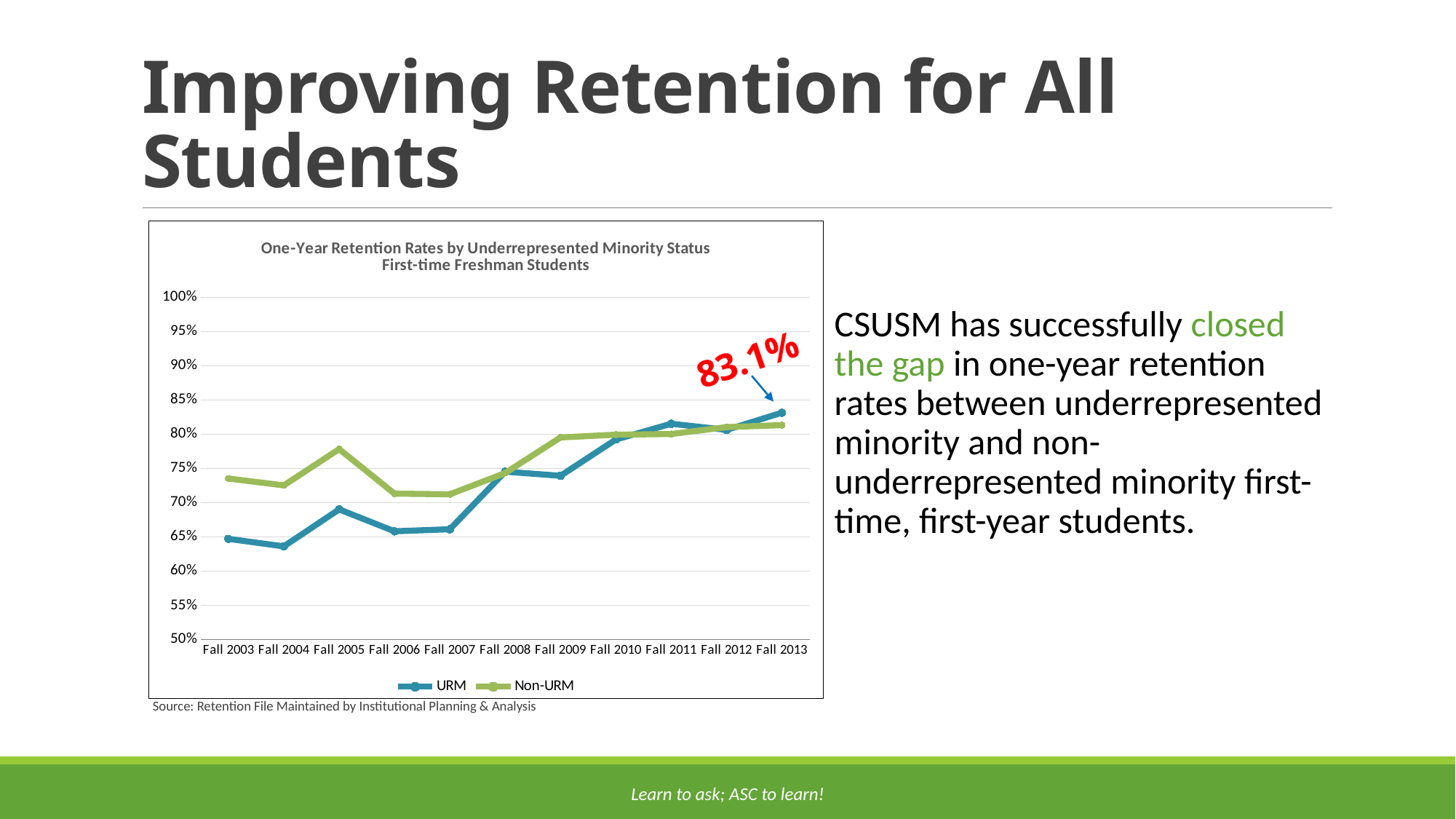
What is the labelled one-year retention rate for URM students in Fall 2013? 83.1% Is the Non-URM retention rate for Fall 2006 greater or less than 75%? less In which fall term does the URM series reach its highest value? Fall 2013 Is the URM retention rate for Fall 2008 greater or less than 80%? less Is the Non-URM retention rate for Fall 2005 greater or less than 75%? greater What are the two series named in the chart's legend? URM and Non-URM Does the URM retention rate generally rise or fall from Fall 2003 to Fall 2013? Rise How many series does the chart's legend list? 2 How many fall terms are plotted along the x axis? 11 What kind of chart is shown on the slide? Line chart In Fall 2007, which series has the higher retention rate, URM or Non-URM? Non-URM